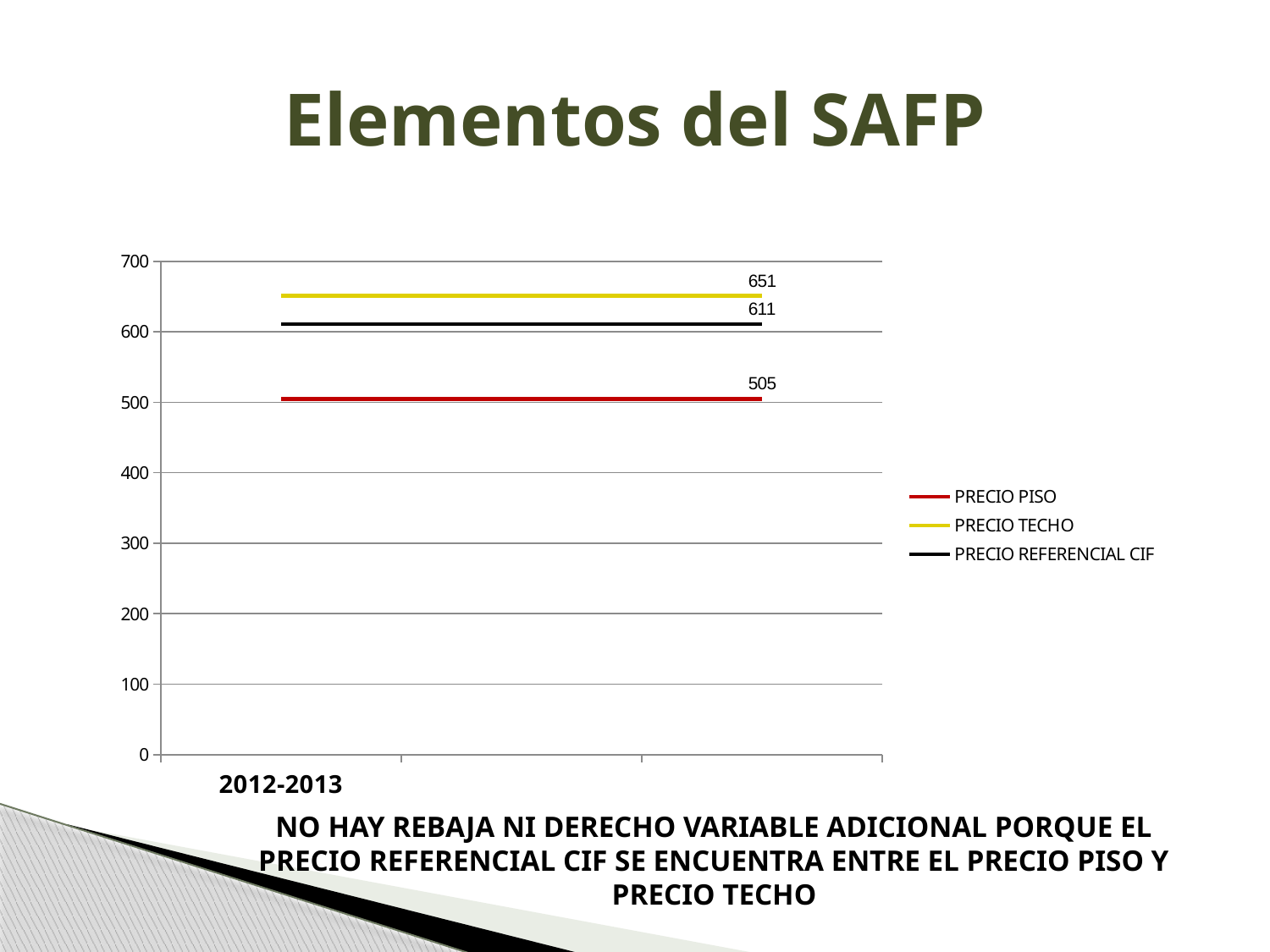
What is the value of PRECIO REFERENCIAL CIF? 611 What is the difference between PRECIO REFERENCIAL CIF and PRECIO PISO? 106 Is the value for PRECIO PISO greater or less than 600? less What kind of chart is shown on the slide? line chart Which series has the lowest value? PRECIO PISO Which series has the highest value? PRECIO TECHO What is the difference between PRECIO TECHO and PRECIO PISO? 146 What colour is the PRECIO REFERENCIAL CIF line? black What is the value of PRECIO TECHO? 651 What is the value of PRECIO PISO? 505 Which is larger, PRECIO REFERENCIAL CIF or PRECIO TECHO? PRECIO TECHO How many series does the legend list? 3